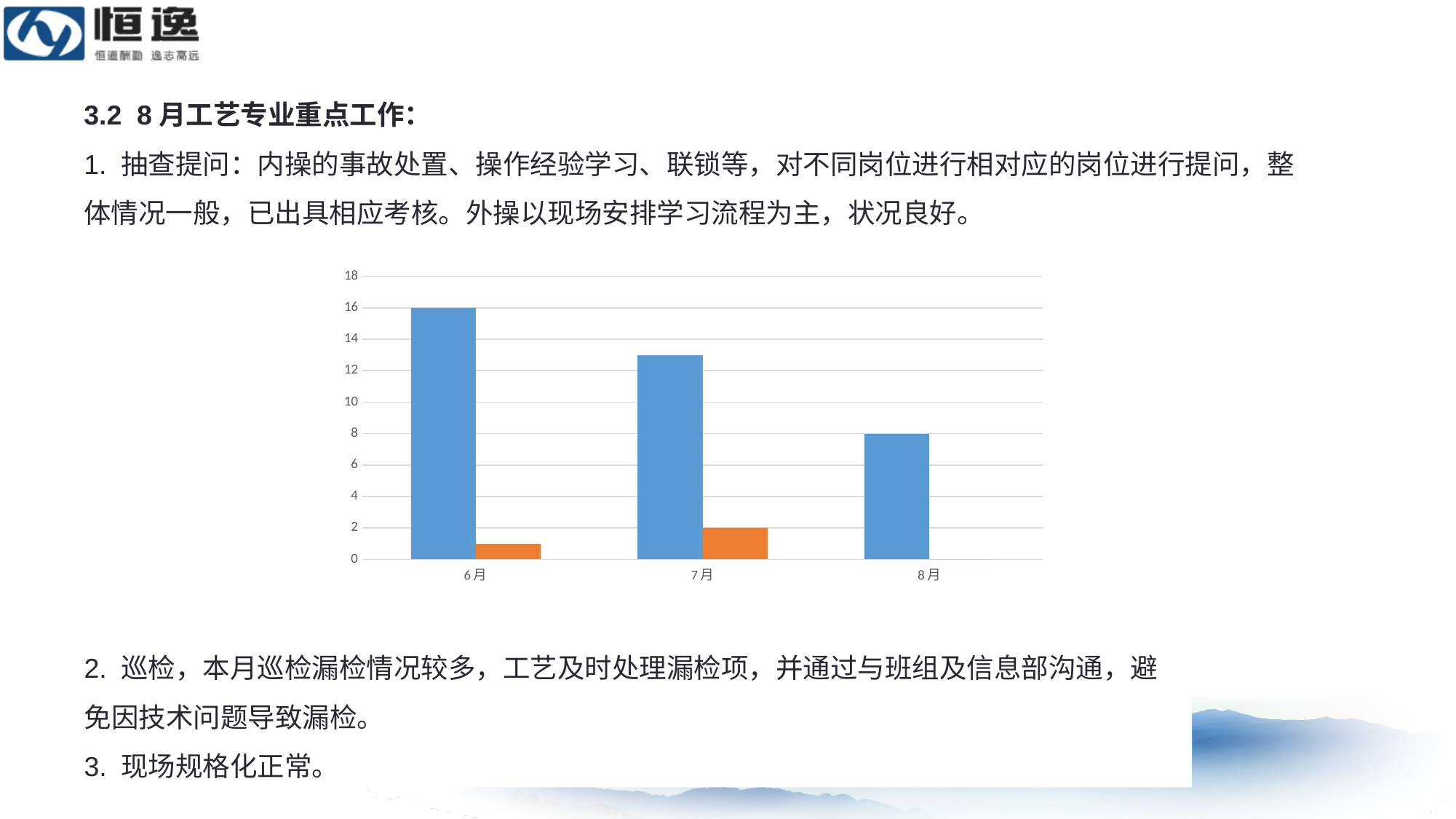
What is the difference between the blue bar for 6月 and the blue bar for 8月? 8 Which month has the highest blue bar? 6月 Is the value of the blue bar for 7月 greater or less than 12? greater What is the value of the orange bar for 7月? 2 Which month has the lowest blue bar? 8月 Which is larger, the blue bar for 6月 or the blue bar for 7月? 6月 What is the value of the blue bar for 6月? 16 What is the value of the blue bar for 8月? 8 Is the value of the orange bar for 6月 greater or less than 2? less Do the blue bars rise or fall from 6月 to 8月? fall How many months are shown on the x axis of the chart? 3 Is the value of the blue bar for 7月 greater or less than 14? less